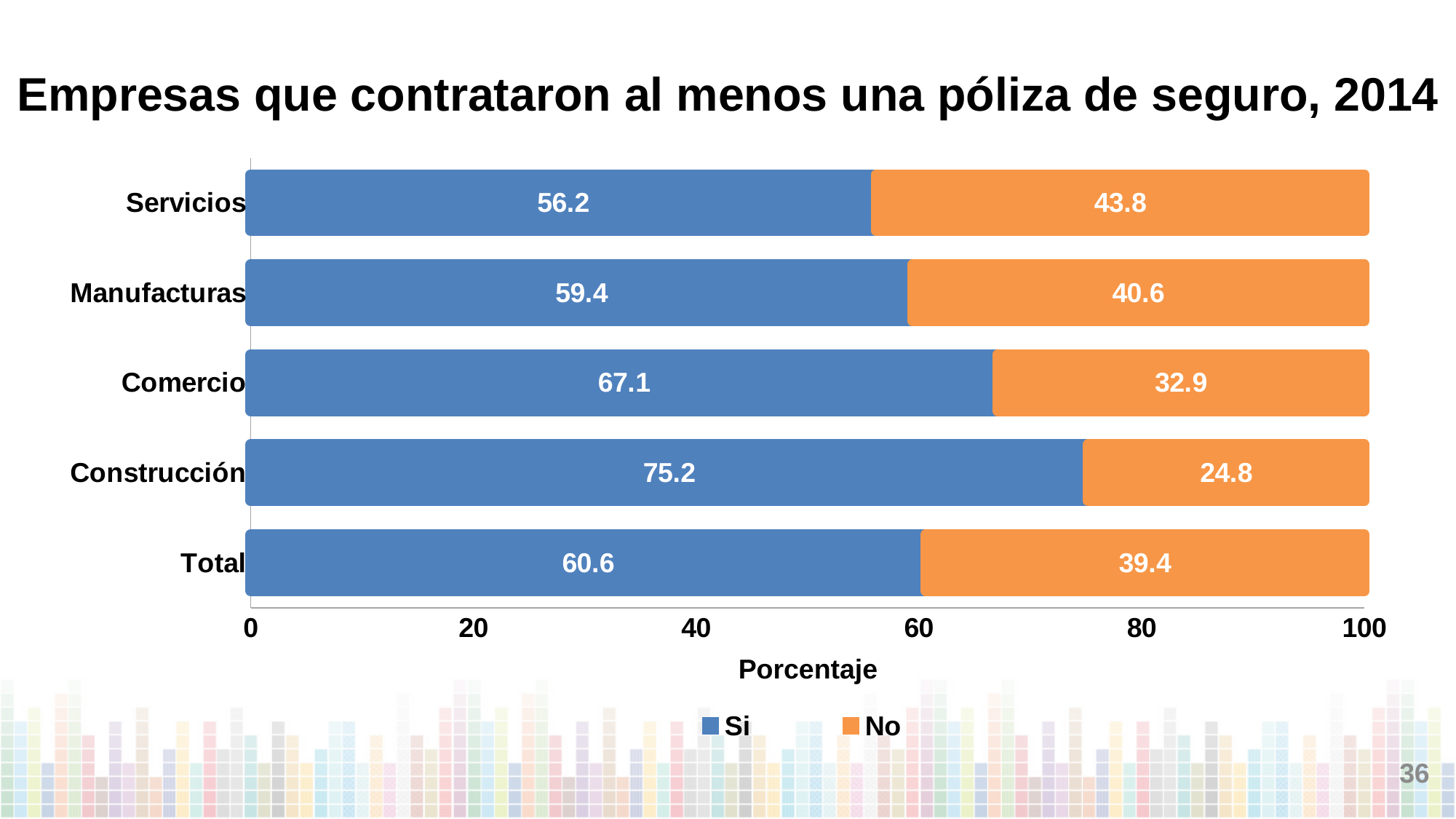
How many categories are shown on the y axis? 5 What kind of chart is shown? Stacked bar chart What is the 'Si' value for Total? 60.6 Which category has the lowest 'Si' value? Servicios How many series does the legend list? 2 What is the 'Si' value for Construcción? 75.2 Which is larger, the 'No' value for Manufacturas or the 'No' value for Comercio? Manufacturas What is the 'No' value for Servicios? 43.8 Which category has the highest 'Si' value? Construcción What is the label of the x axis? Porcentaje What is the total of the stacked bar for Comercio? 100 What is the difference between the 'Si' values for Comercio and Manufacturas? 7.7